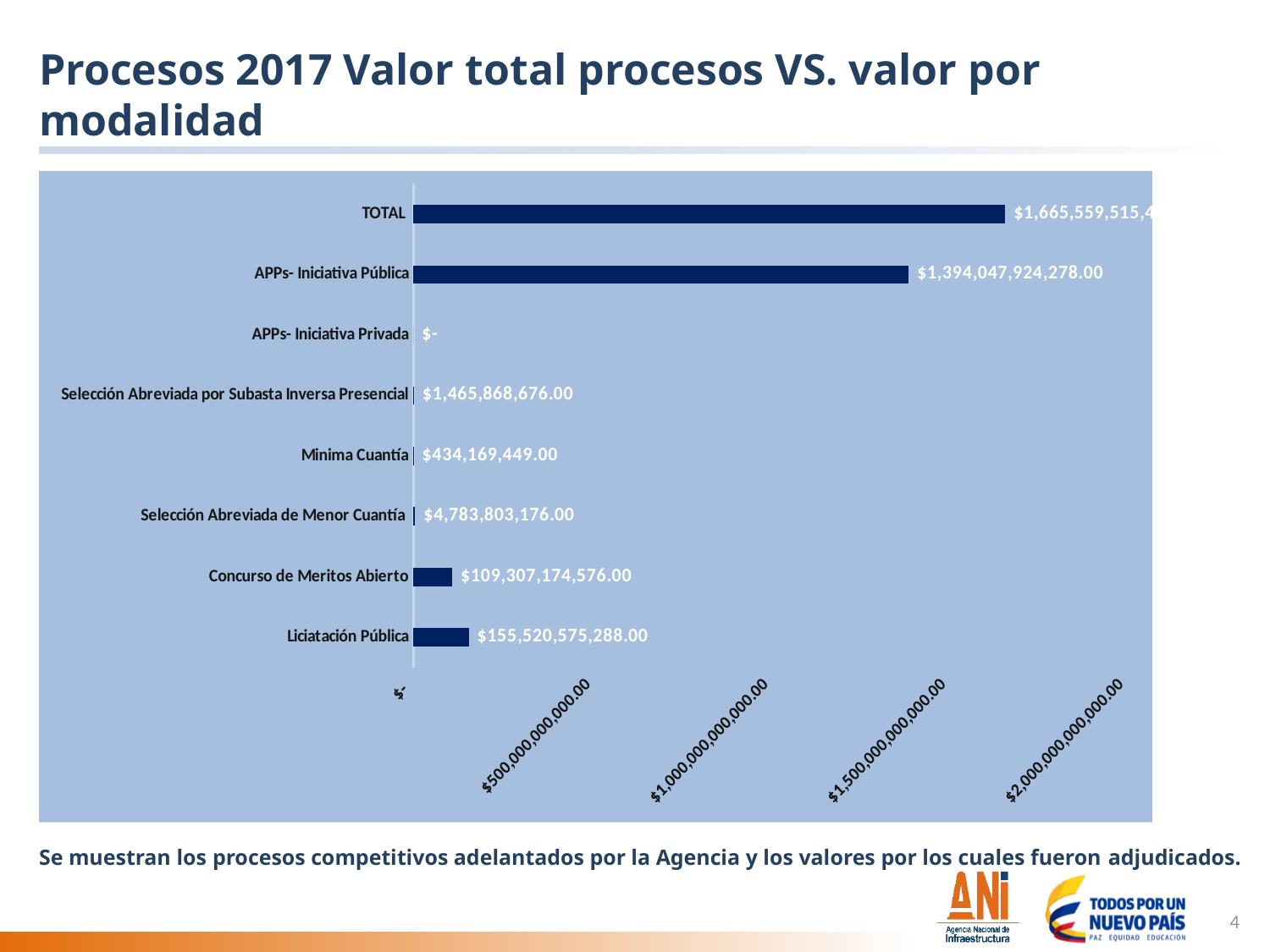
What is the value for APPs- Iniciativa Pública? $1,394,047,924,278.00 What is the value for Liciatación Pública? $155,520,575,288.00 What is the value for Concurso de Meritos Abierto? $109,307,174,576.00 What is the value for Selección Abreviada de Menor Cuantía? $4,783,803,176.00 Excluding TOTAL, which modality has the highest value? APPs- Iniciativa Pública How many categories are shown on the chart? 8 Which category has the lowest value? APPs- Iniciativa Privada What is the value for Selección Abreviada por Subasta Inversa Presencial? $1,465,868,676.00 What is the difference between the values for Liciatación Pública and Concurso de Meritos Abierto? $46,213,400,712.00 Is the value for APPs- Iniciativa Pública greater or less than $1,000,000,000,000.00? greater Which is larger, the value for Minima Cuantía or the value for Selección Abreviada de Menor Cuantía? Selección Abreviada de Menor Cuantía What is the value for Minima Cuantía? $434,169,449.00